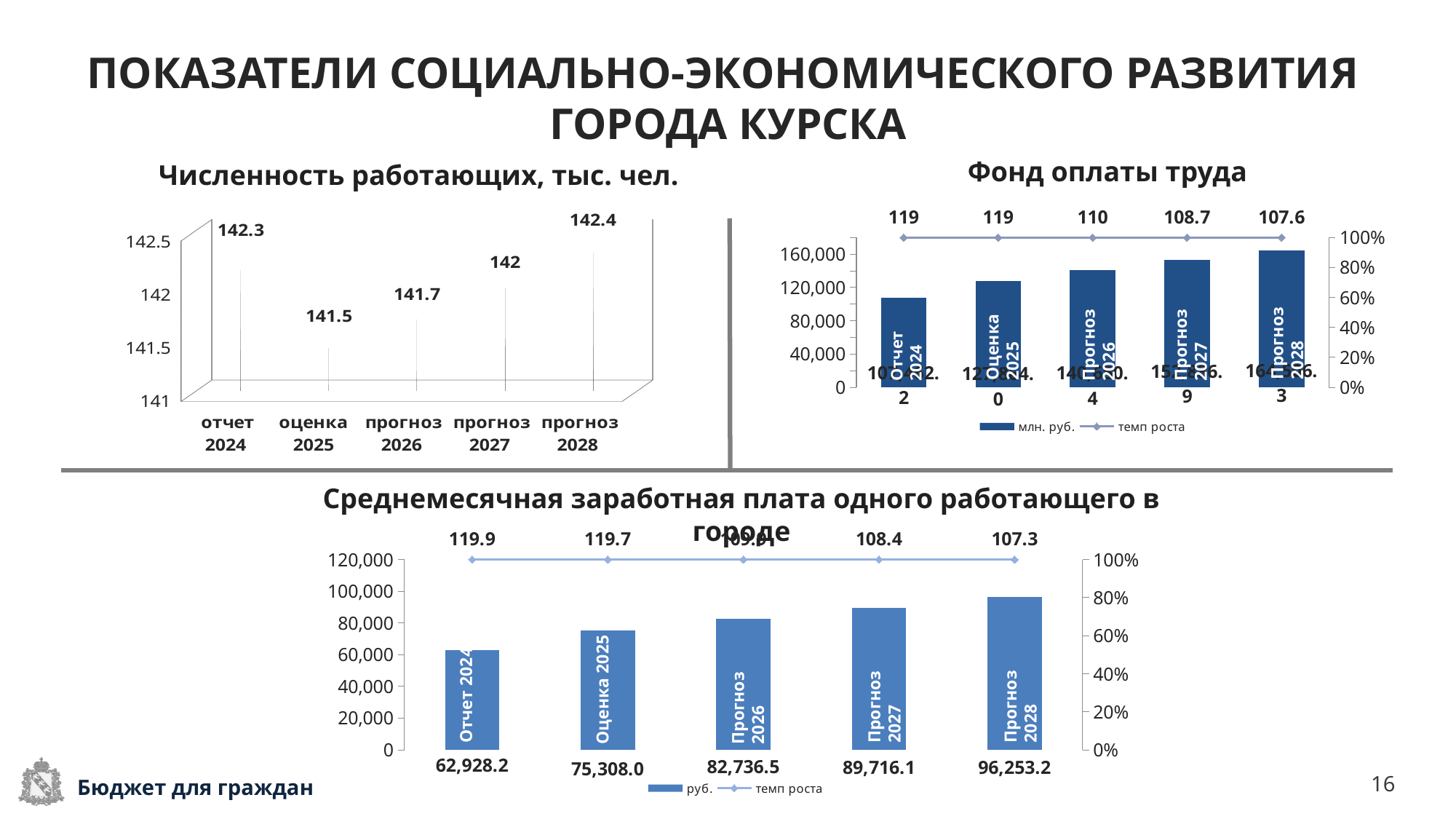
In the chart 'Численность работающих, тыс. чел.', which category has the highest value? прогноз 2028 In the chart 'Фонд оплаты труда', what is the темп роста value for Прогноз 2027? 108.7 In the chart 'Фонд оплаты труда', how many series does the legend list? 2 In the chart 'Среднемесячная заработная плата одного работающего в городе', do the bar values rise or fall from Отчет 2024 to Прогноз 2028? rise In the chart 'Численность работающих, тыс. чел.', which category has the lowest value? оценка 2025 In the chart 'Численность работающих, тыс. чел.', how many categories are shown on the x axis? 5 In the chart 'Среднемесячная заработная плата одного работающего в городе', what is the value for Прогноз 2028? 96,253.2 In the chart 'Среднемесячная заработная плата одного работающего в городе', what is the темп роста value for Прогноз 2027? 108.4 In the chart 'Численность работающих, тыс. чел.', what is the difference between the values for прогноз 2028 and оценка 2025? 0.9 In the chart 'Фонд оплаты труда', is the bar for Отчет 2024 greater or less than 120,000? less In the chart 'Численность работающих, тыс. чел.', what is the value for отчет 2024? 142.3 In the chart 'Среднемесячная заработная плата одного работающего в городе', what is the difference between the values for Оценка 2025 and Отчет 2024? 12,379.8